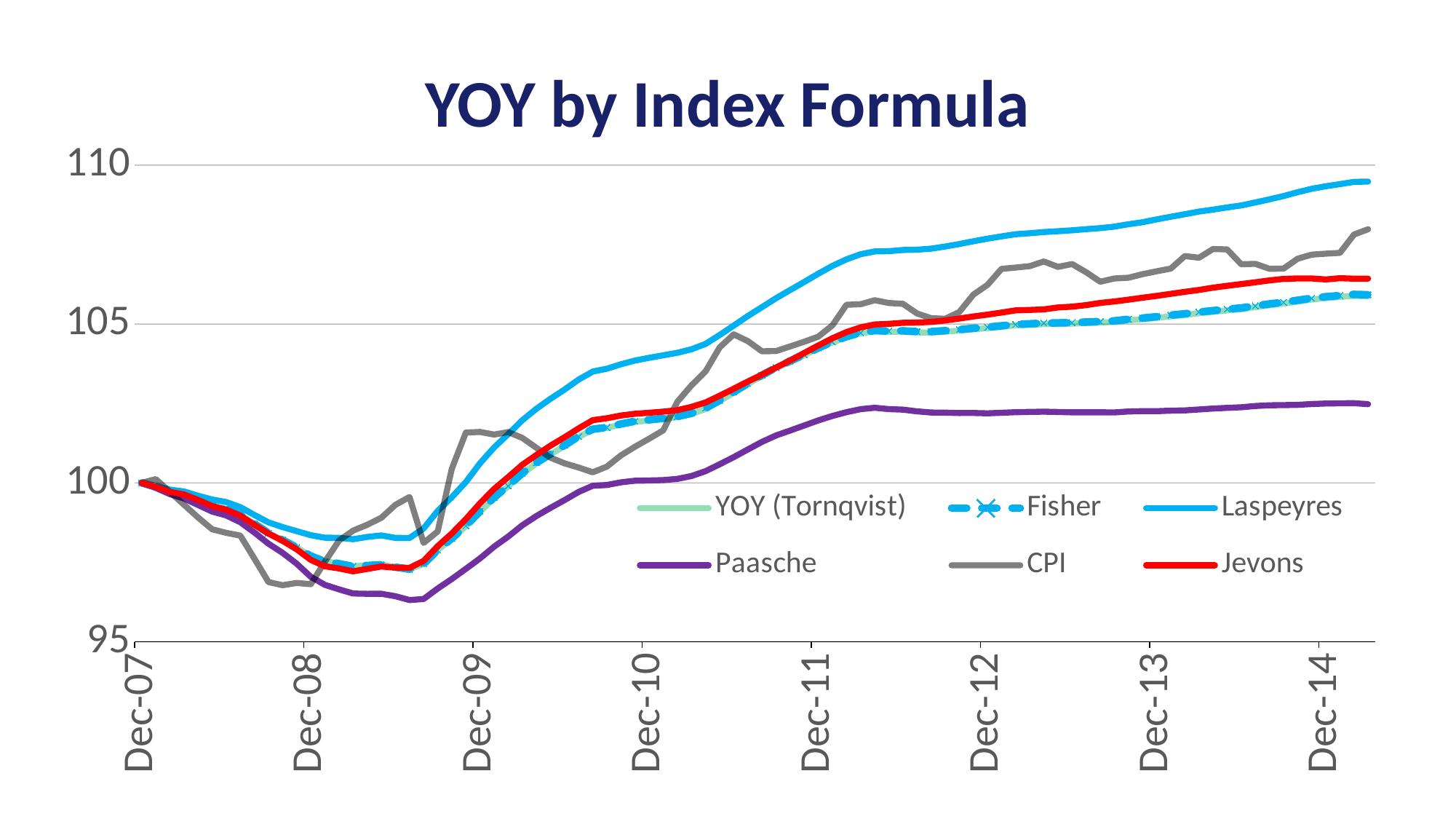
Which series has the lowest value at Dec-14? Paasche How many year labels are shown on the x axis? 8 What is the title of the chart? YOY by Index Formula Which series has the highest value at Dec-14? Laspeyres Is the value for Laspeyres at Dec-14 greater or less than 105? greater Is the value for Paasche at Dec-08 greater or less than 100? less Do the values for Laspeyres rise or fall from Dec-09 to Dec-14? rise Is the value for Paasche at Dec-14 greater or less than 105? less Which series is drawn as a dashed line? Fisher How many series does the legend list? 6 At Dec-14, which is higher: Laspeyres or Paasche? Laspeyres What kind of chart is shown on the slide? line chart